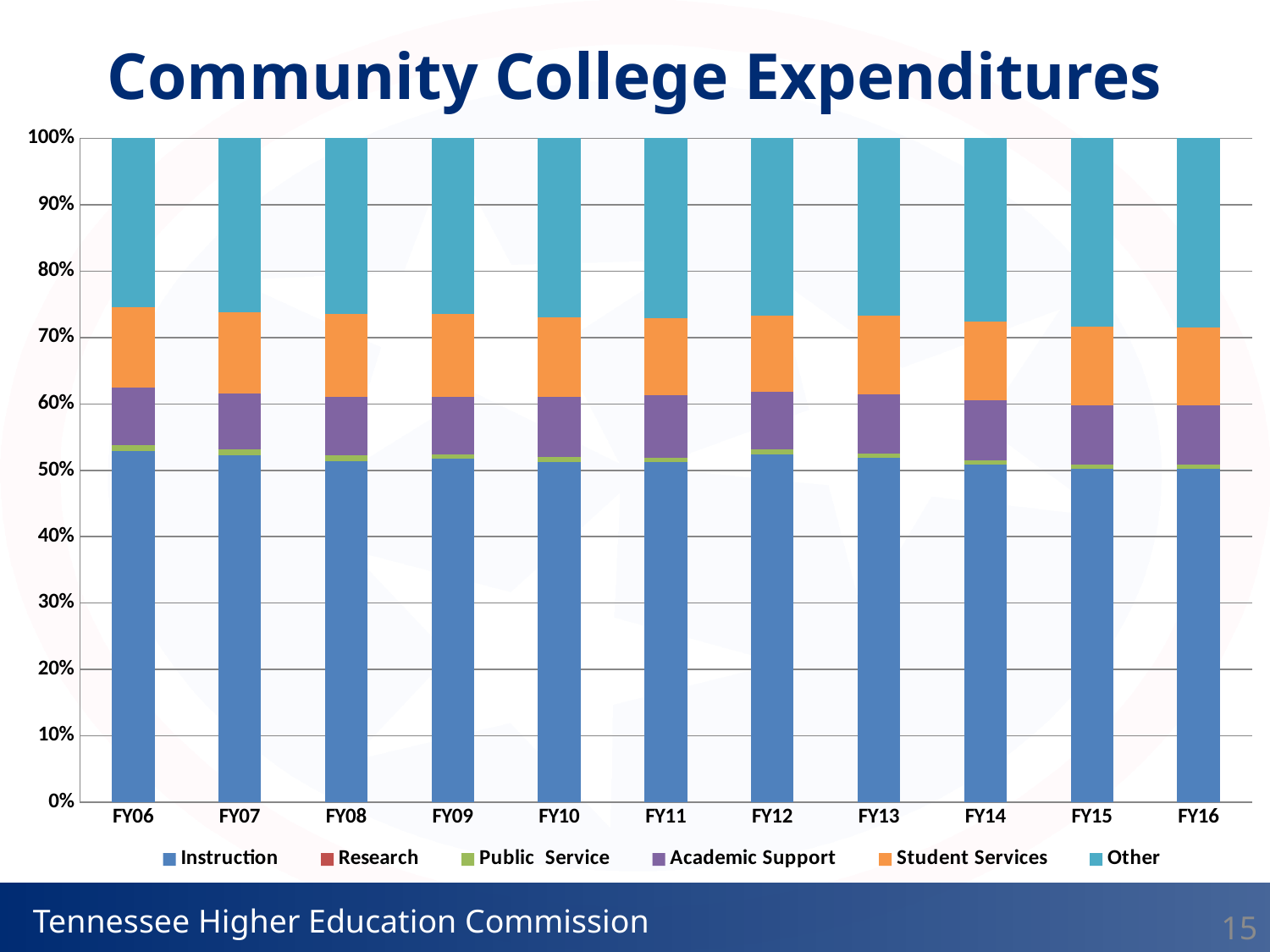
Which series makes up the largest share of the FY06 bar? Instruction Does the Instruction share rise or fall from FY06 to FY16? fall What is the title of the chart? Community College Expenditures In FY12, which is larger: the Student Services segment or the Academic Support segment? Student Services Is the Instruction share for FY06 greater or less than 60%? less Which series is listed last in the legend? Other Is the Instruction share for FY06 greater or less than 50%? greater In FY10, which is larger: the Instruction segment or the Other segment? Instruction What is the total of each stacked bar? 100% How many fiscal years are shown on the x axis? 11 How many series does the legend list? 6 What kind of chart is shown on the slide? Stacked bar chart